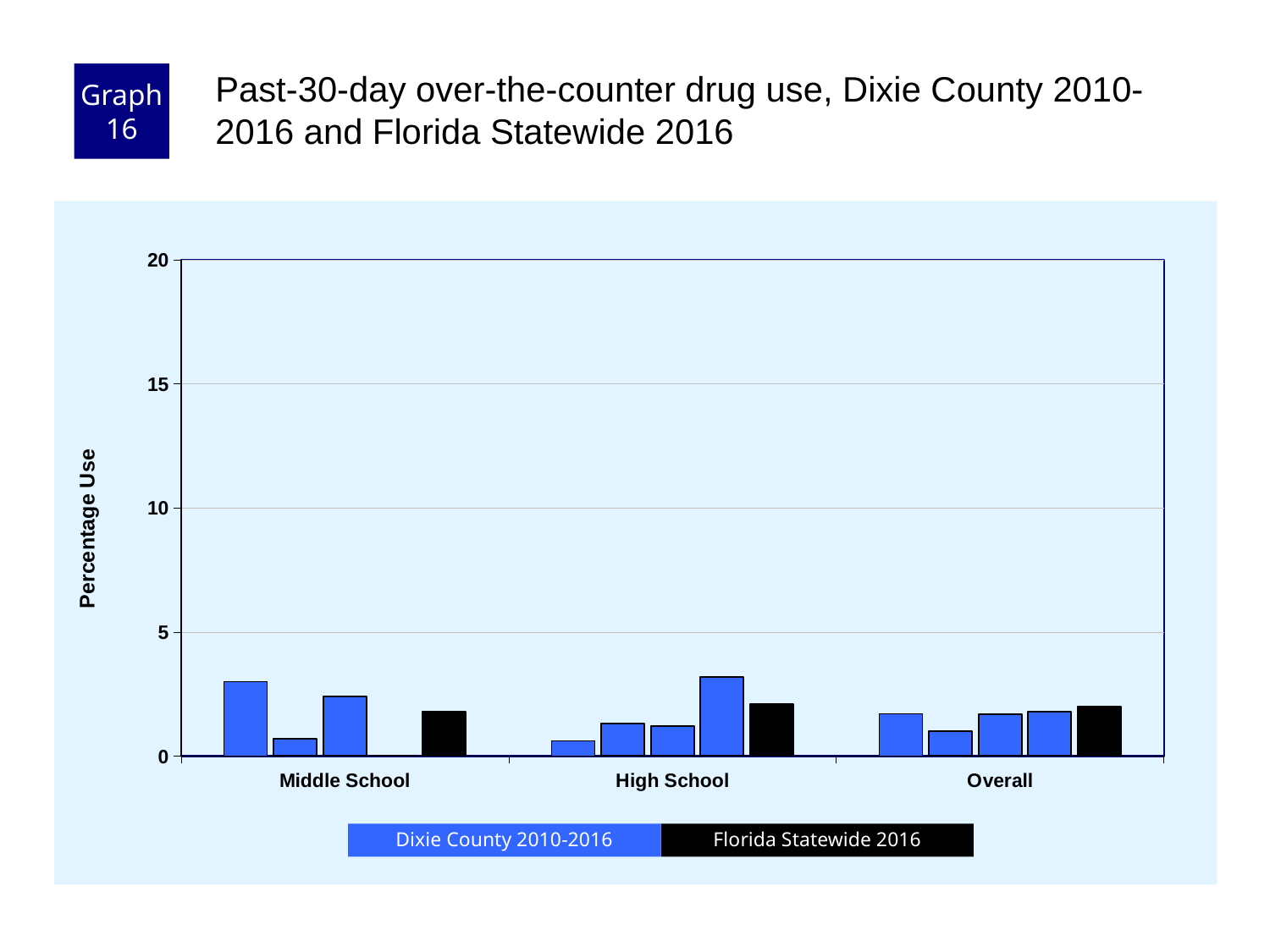
What is the title of the chart? Past-30-day over-the-counter drug use, Dixie County 2010-2016 and Florida Statewide 2016 Is the Florida Statewide 2016 value for High School greater or less than 10? less Is the tallest Dixie County 2010-2016 bar in the Middle School group greater or less than 5? less How many series does the legend list? 2 Is the Florida Statewide 2016 value for Overall greater or less than 5? less What kind of chart is shown on the slide? bar chart How many categories are shown on the x axis? 3 What is the label on the y axis? Percentage Use What is the highest value shown on the y axis? 20